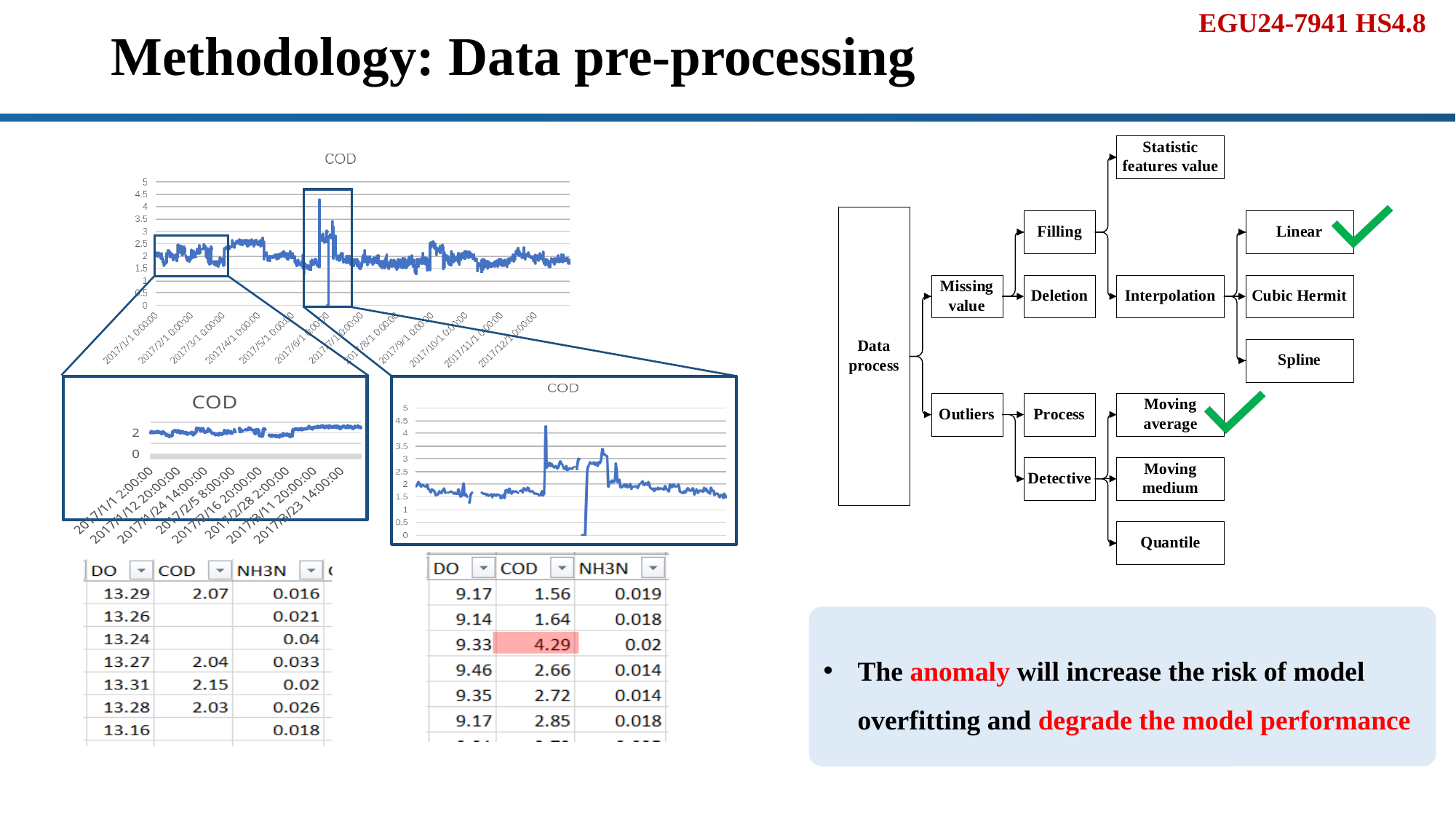
In the bottom-right COD chart, is the highest peak of the line greater or less than 4? greater In the bottom-right COD chart, is the lowest point of the line greater or less than 0.5? less In the top COD chart, apart from the spike around 2017/6, are the values greater or less than 3? less What is the first x-axis label on the bottom-left COD chart? 2017/1/1 2:00:00 What is the title of the top chart on the left of the slide? COD What is the highest y-axis tick value on the top COD chart? 5 What kind of chart is the top COD chart on the left of the slide? line chart How many COD line charts are shown on the slide? 3